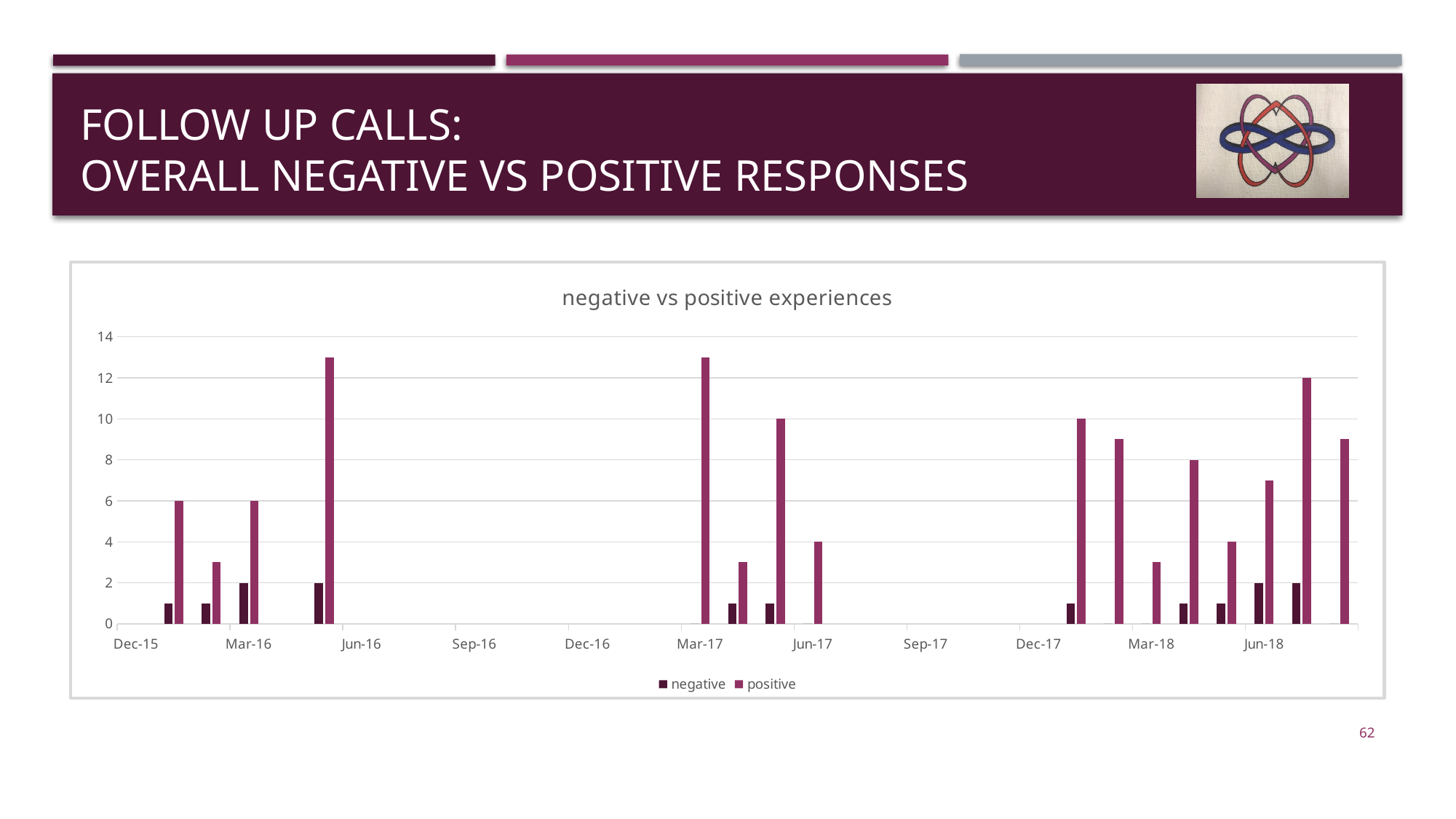
How many positive bars are plotted on the chart? 16 Is the tallest negative bar greater or less than 4? less What is the highest value shown on the vertical axis? 14 What is the highest value reached by any negative bar? 2 Are there any bars plotted between Jun-16 and Dec-16? No Which series has the taller bars throughout the chart, negative or positive? positive How many date labels are shown on the horizontal axis? 11 Is the tallest positive bar greater or less than 12? greater How many series does the legend list? 2 What are the two series named in the legend? negative and positive What kind of chart is shown on the slide? bar chart